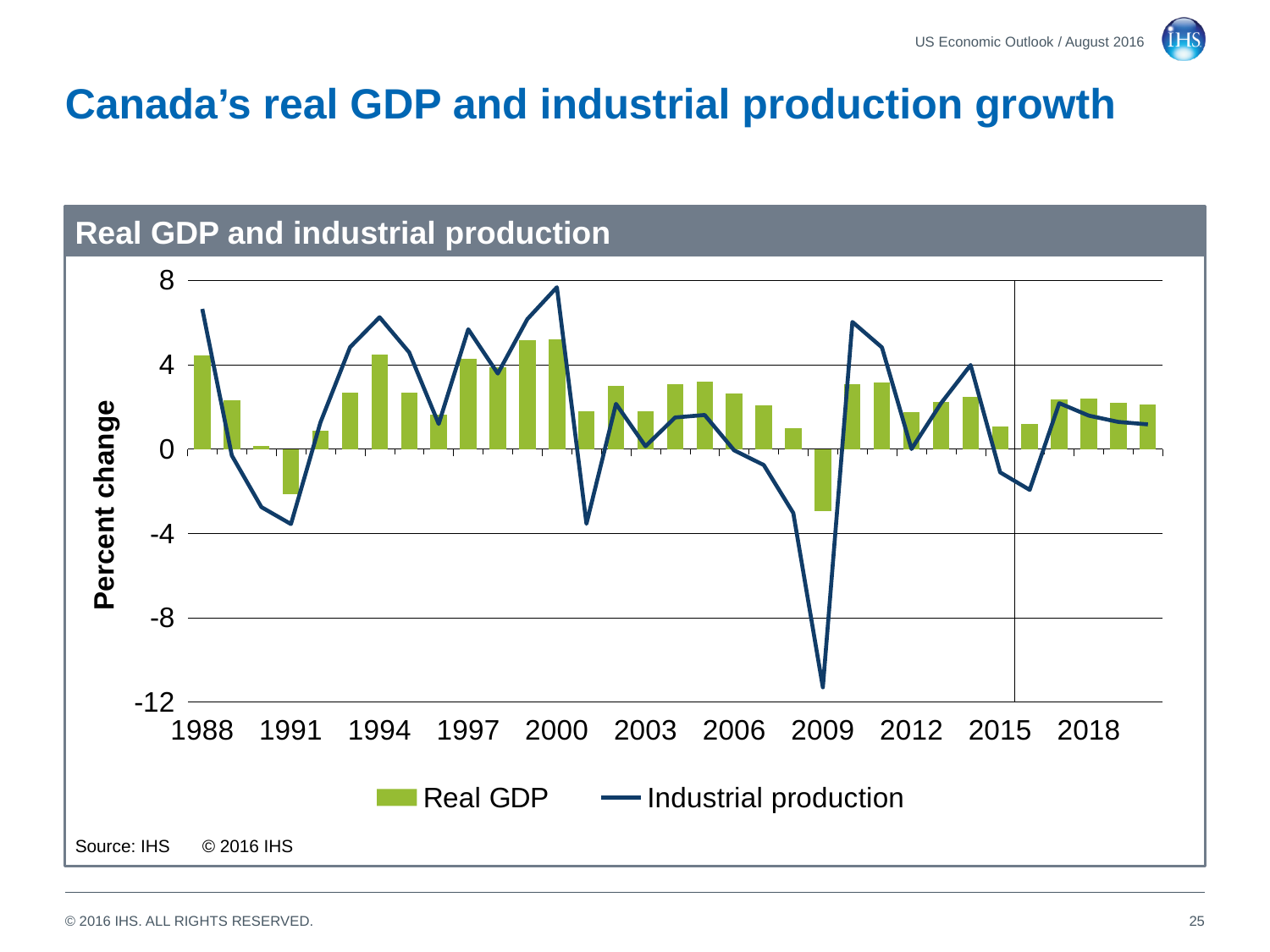
Which is larger, Real GDP in 1988 or Real GDP in 1991? 1988 Is the value of Real GDP in 1991 greater or less than 0? less Which series is drawn as a line in the chart? Industrial production Is the value of Industrial production in 2009 greater or less than -8? less What kind of chart is shown on the slide? A combined bar and line chart In which year does Industrial production reach its highest value? 2000 In which year does Industrial production reach its lowest value? 2009 In which year does Real GDP reach its lowest value? 2009 What is the label on the vertical axis of the chart? Percent change Is the value of Industrial production in 2000 greater or less than 4? greater How many series does the legend list? 2